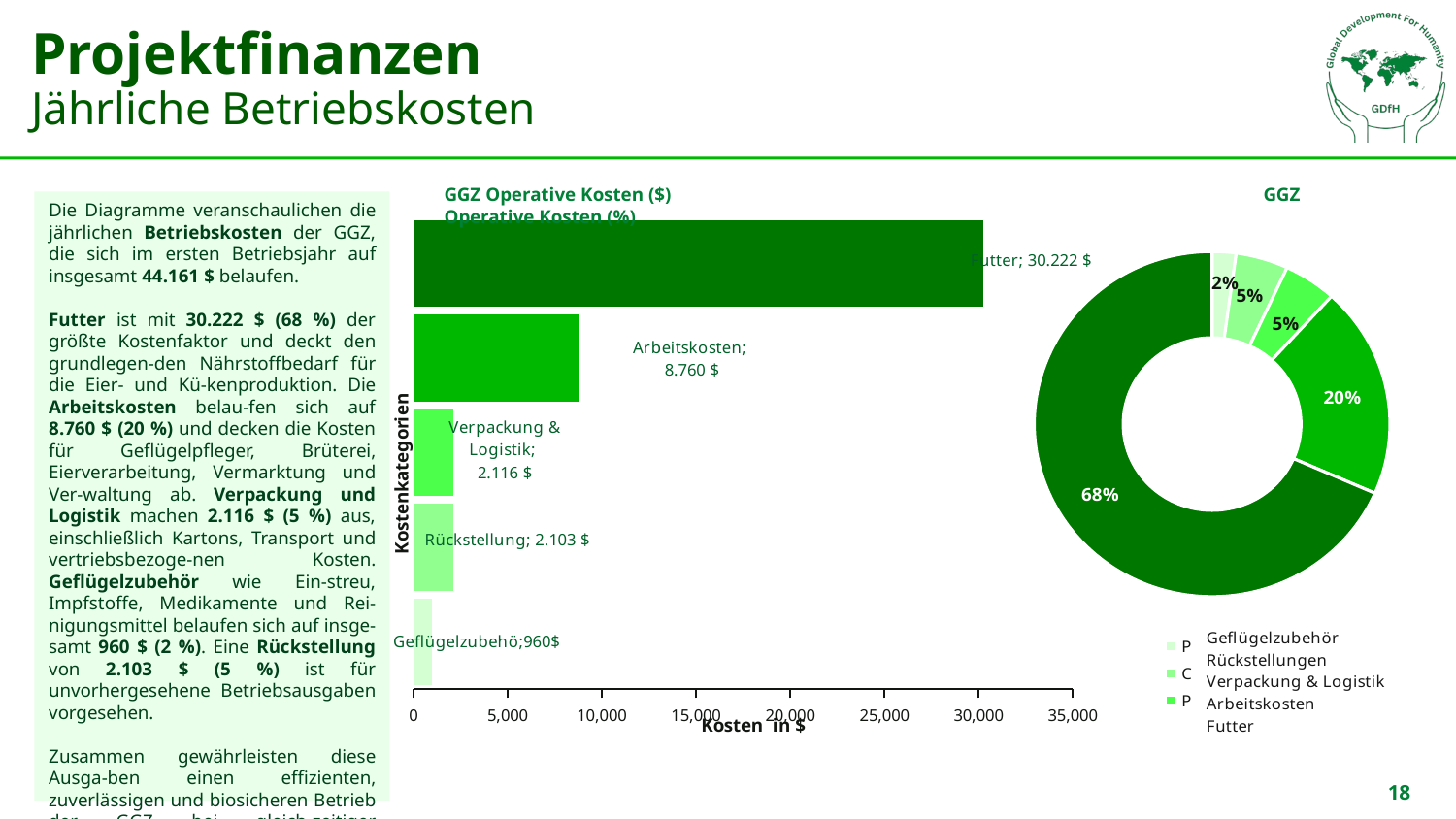
In the bar chart 'GGZ Operative Kosten ($)', what is the value for Verpackung & Logistik? 2.116 $ In the bar chart 'GGZ Operative Kosten ($)', which category has the lowest cost? Geflügelzubehör What is the x-axis title of the bar chart 'GGZ Operative Kosten ($)'? Kosten in $ In the bar chart 'GGZ Operative Kosten ($)', which category has the highest cost? Futter In the donut chart on the right, what share does Futter account for? 68% In the bar chart 'GGZ Operative Kosten ($)', what is the value for Arbeitskosten? 8.760 $ In the bar chart 'GGZ Operative Kosten ($)', what is the difference between the Futter and Arbeitskosten values? 21.462 $ In the bar chart 'GGZ Operative Kosten ($)', what is the value for Futter? 30.222 $ How many categories are shown in the bar chart 'GGZ Operative Kosten ($)'? 5 What kind of chart is the chart on the left titled 'GGZ Operative Kosten ($)'? bar chart In the bar chart 'GGZ Operative Kosten ($)', is the value for Arbeitskosten greater or less than 10,000? less In the bar chart 'GGZ Operative Kosten ($)', what is the value for Rückstellung? 2.103 $